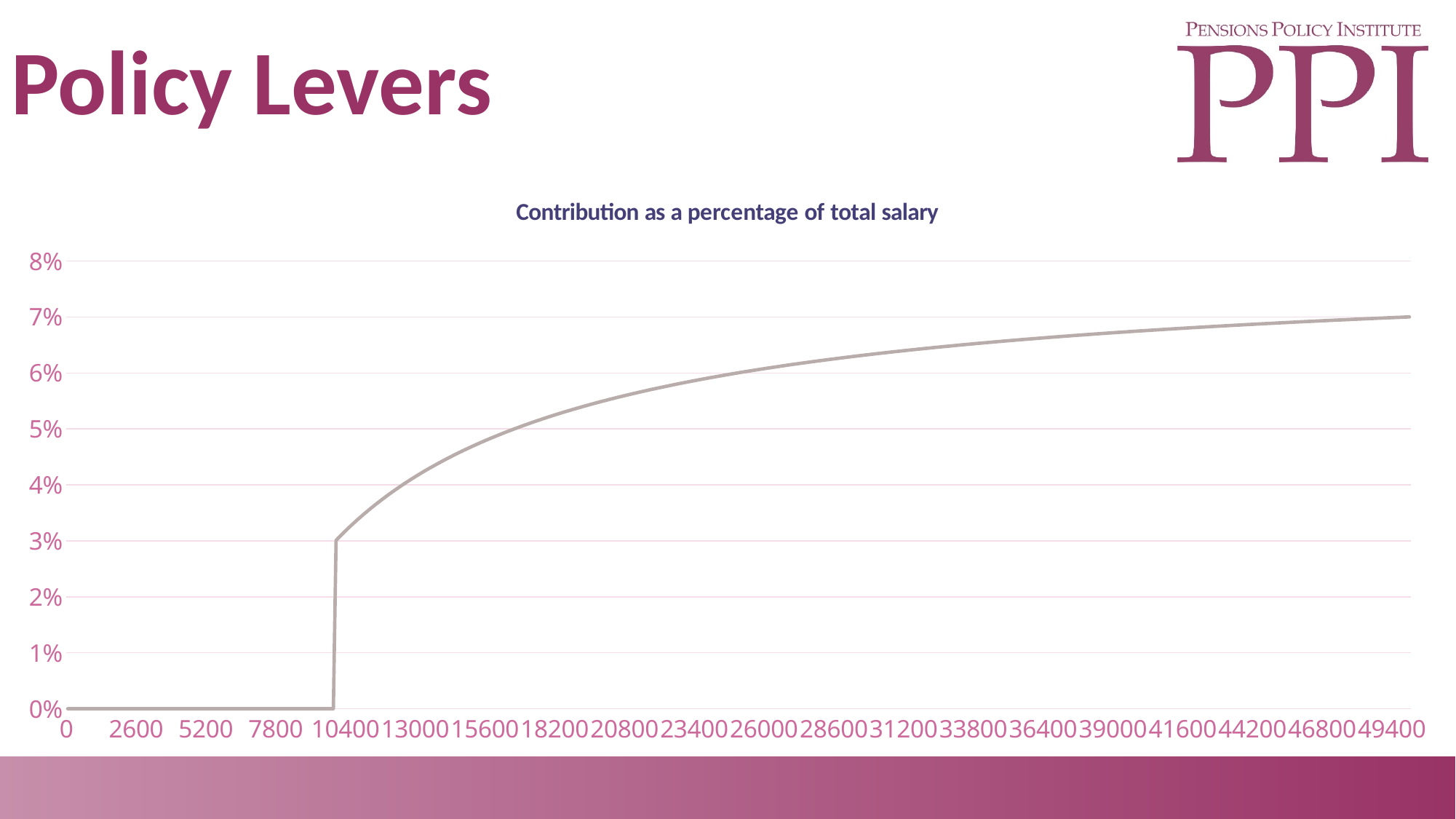
Which has the larger contribution percentage, a salary of 13000 or a salary of 49400? 49400 Is the contribution percentage at a salary of 13000 greater or less than 3%? greater Is the contribution percentage at a salary of 18200 greater or less than 5%? greater Is the contribution percentage at a salary of 39000 greater or less than 7%? less What is the contribution percentage at a salary of 49400? 7% What is the contribution percentage at a salary of 0? 0% What is the contribution percentage at a salary of 7800? 0% What type of chart is shown on the slide? line chart What is the title of the chart? Contribution as a percentage of total salary Does the contribution percentage generally rise or fall as salary increases along the x axis? rise